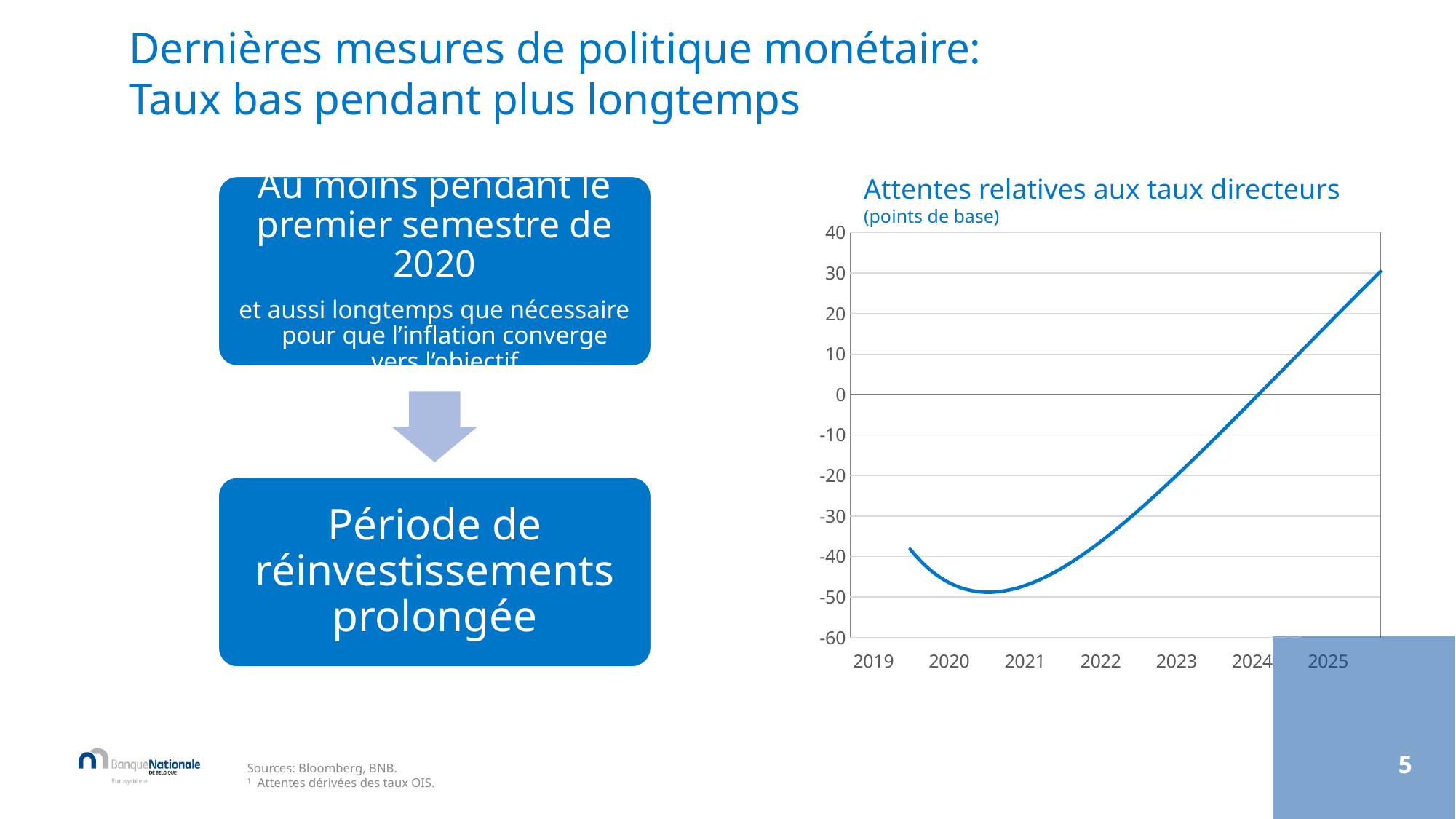
In what unit are the values of the chart expressed, according to the subtitle? points de base Is the value of the line at 2021 greater or less than -40? less Does the line rise or fall between 2021 and 2025? rise Is the value of the line at 2024 greater or less than 10? less At which year on the x axis does the line reach its highest value? 2025 What kind of chart is shown on the slide? line chart Is the value of the line at 2022 greater or less than -30? less What is the title of the chart on the slide? Attentes relatives aux taux directeurs Around which year does the line reach its lowest point? 2020 How many year labels are shown on the x axis? 7